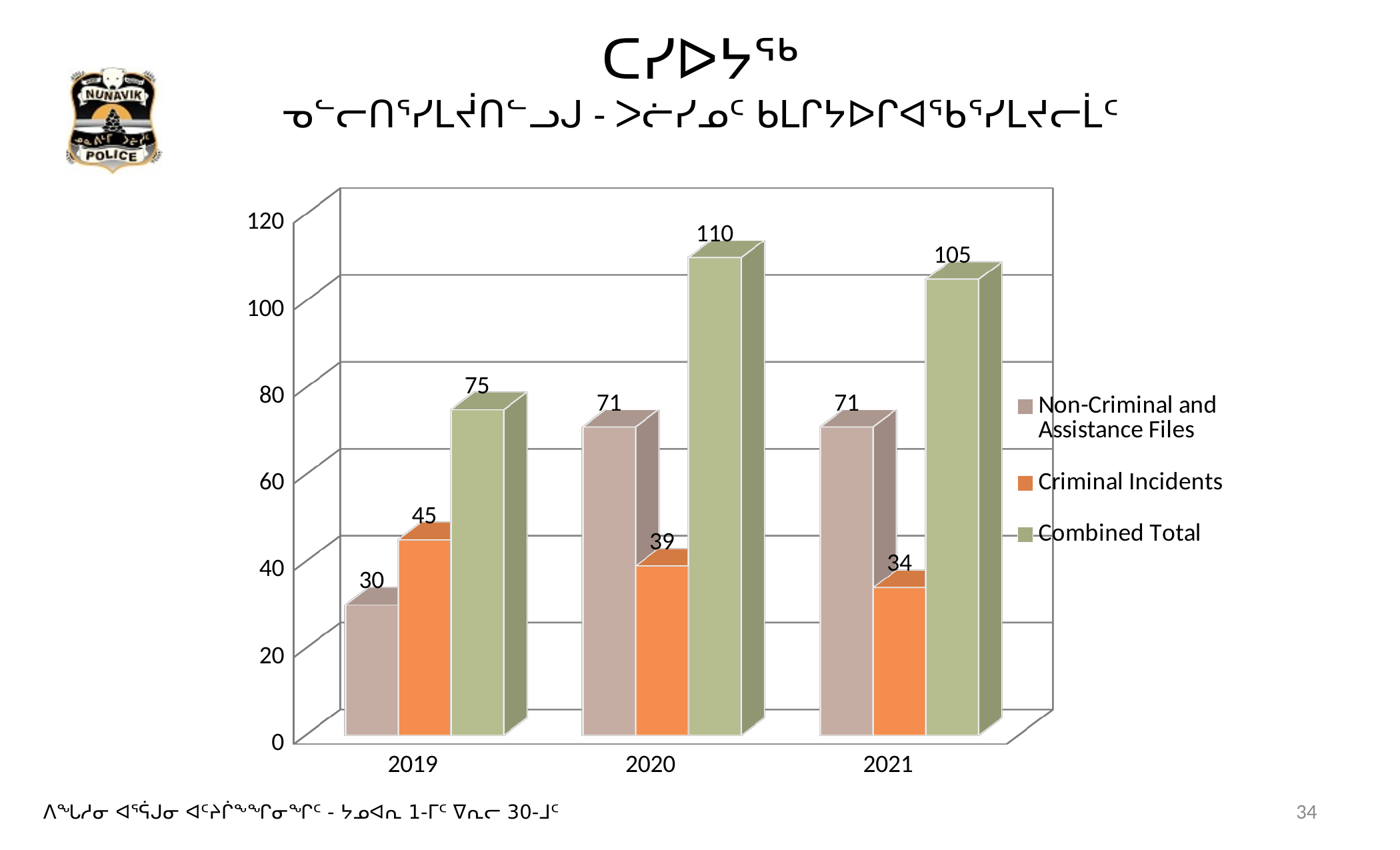
What is the Combined Total for 2021? 105 What kind of chart is shown on the slide? bar chart Do the Criminal Incidents values rise or fall from 2019 to 2021? fall In which year is the Criminal Incidents value lowest? 2021 In which year is the Combined Total highest? 2020 What is the difference between the Combined Total in 2020 and in 2019? 35 How many years are shown on the x axis? 3 What is the value for Criminal Incidents in 2020? 39 Which is larger: Criminal Incidents in 2019 or Criminal Incidents in 2021? Criminal Incidents in 2019 Is the Combined Total for 2020 greater or less than 100? greater How many series does the legend list? 3 What is the value for Non-Criminal and Assistance Files in 2019? 30